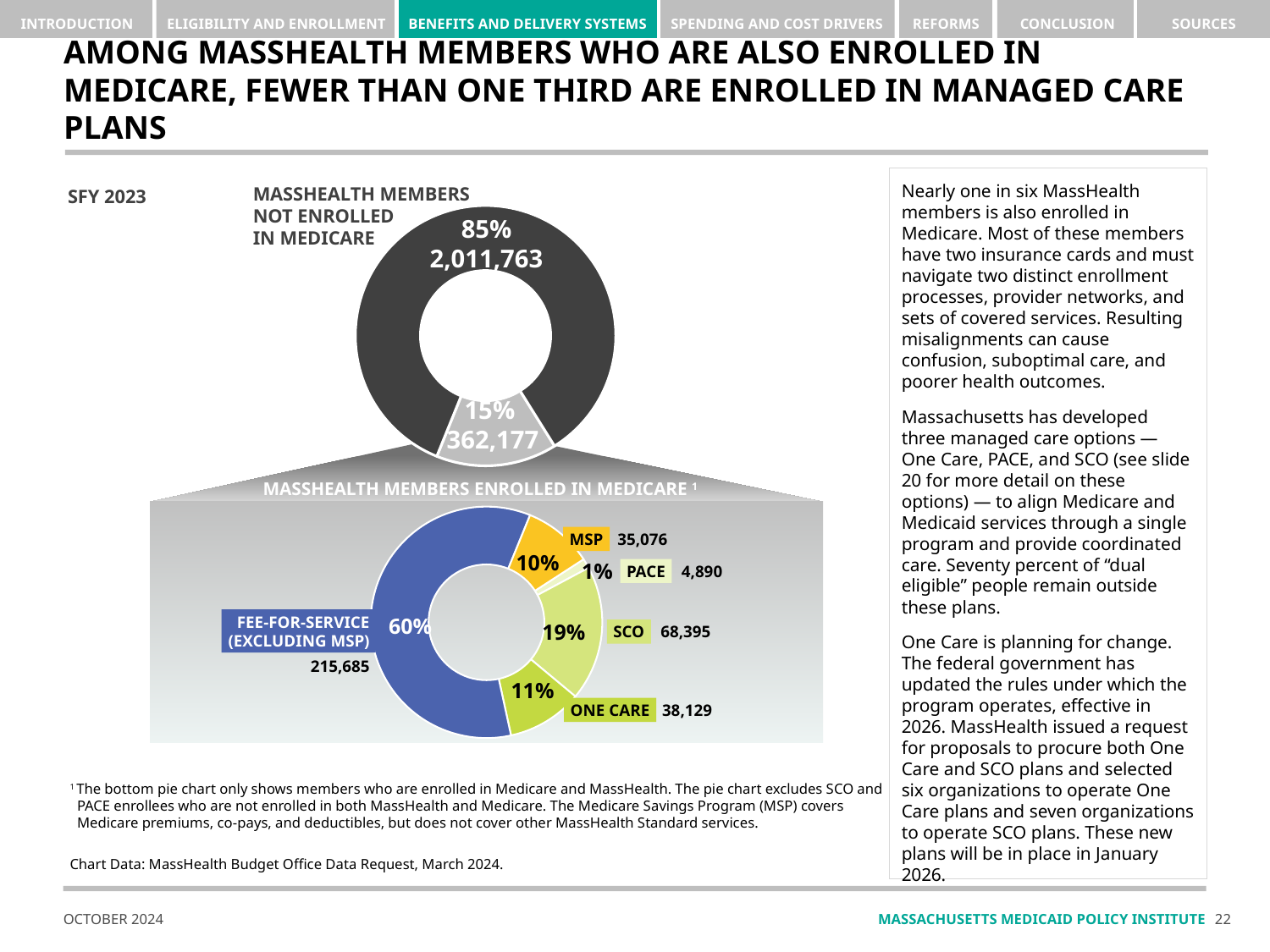
What fiscal year is shown on the slide for the charts? SFY 2023 In the bottom chart (MassHealth members enrolled in Medicare), which category has the largest number of members? Fee-for-service (excluding MSP) In the bottom chart (MassHealth members enrolled in Medicare), what is the difference in members between SCO and One Care? 30,266 In the top chart, how many MassHealth members are not enrolled in Medicare? 2,011,763 How many categories does the bottom chart (MassHealth members enrolled in Medicare) show? 5 In the bottom chart (MassHealth members enrolled in Medicare), which has more members, MSP or One Care? One Care In the bottom chart (MassHealth members enrolled in Medicare), which category has the smallest number of members? PACE In the top chart, how many MassHealth members are enrolled in Medicare? 362,177 In the bottom chart (MassHealth members enrolled in Medicare), how many members are in SCO? 68,395 What type of chart is used on this slide? Pie (donut) chart In the bottom chart (MassHealth members enrolled in Medicare), what share of members are in One Care? 11% In the top chart, what percentage of MassHealth members are enrolled in Medicare? 15%